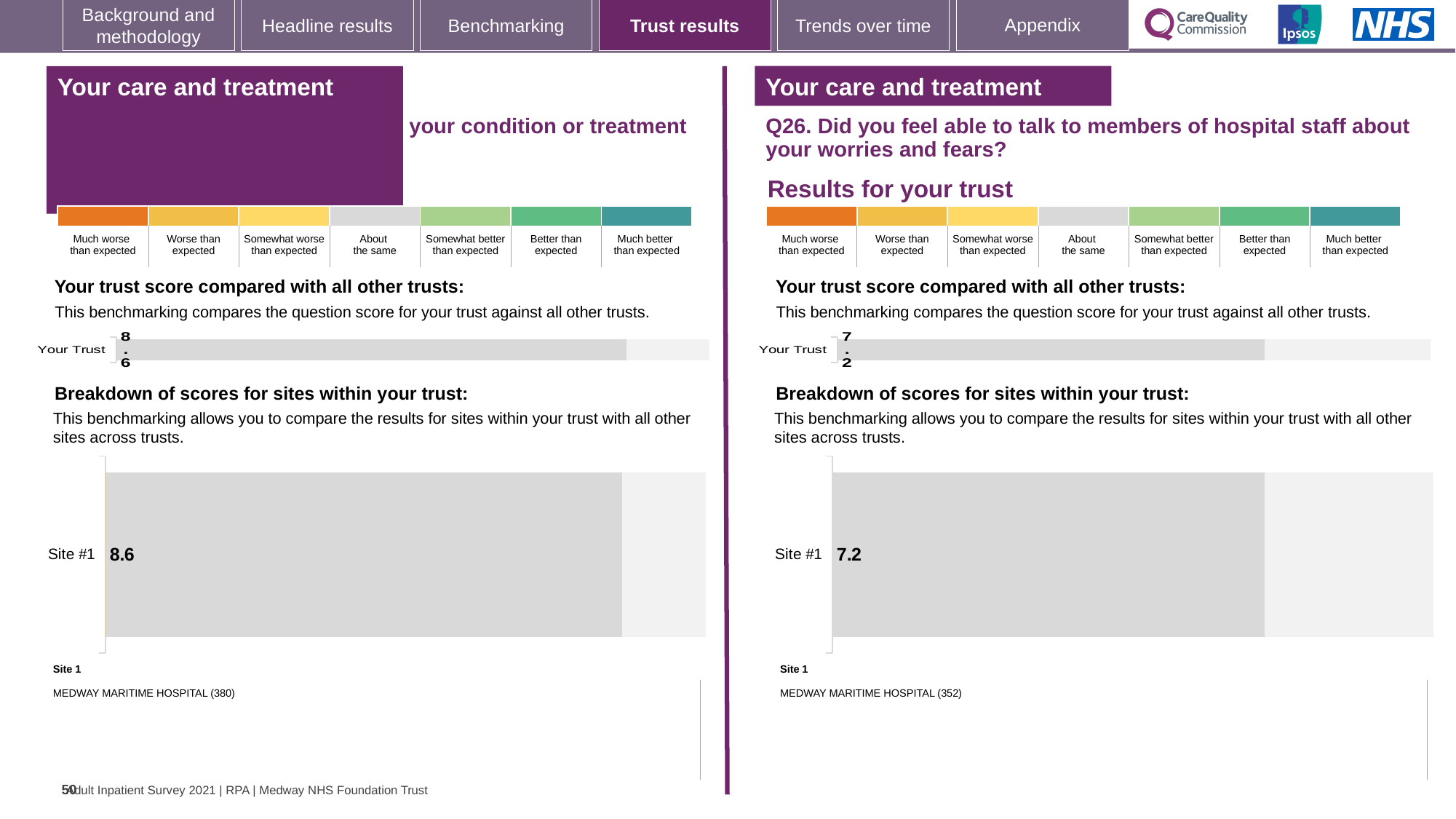
On the right panel, which question number is the chart about? Q26 On the left panel, in the 'Your trust score compared with all other trusts' chart, what is the value for Your Trust? 8.6 How many sites are shown in the 'Breakdown of scores for sites within your trust' chart on the left panel? 1 What is the difference between the Site #1 score on the left panel and the Site #1 score on the right panel (Q26)? 1.4 What type of chart is used to show the Site #1 score on the right panel (Q26)? Bar chart Which is larger: the Your Trust score on the left panel or the Your Trust score on the right panel (Q26)? Left panel (8.6) How many bars are plotted in the 'Your trust score compared with all other trusts' chart on the right panel (Q26)? 1 On the right panel (Q26), which site is listed as Site 1 below the chart? MEDWAY MARITIME HOSPITAL (352) On the left panel, in the 'Breakdown of scores for sites within your trust' chart, what is the value for Site #1? 8.6 On the right panel (Q26), in the 'Breakdown of scores for sites within your trust' chart, what is the value for Site #1? 7.2 On the right panel (Q26), in the 'Your trust score compared with all other trusts' chart, what is the value for Your Trust? 7.2